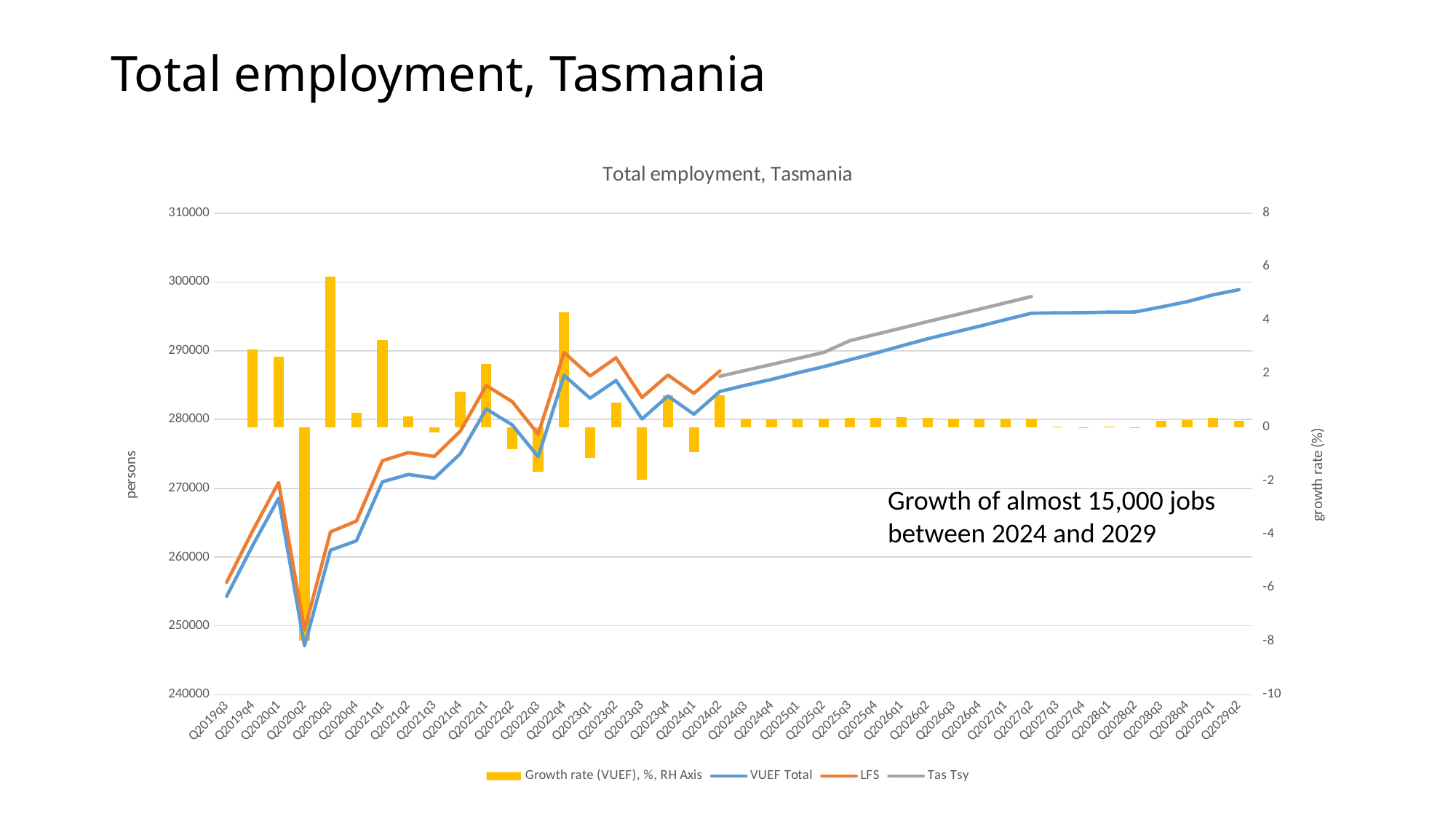
In which quarter does the VUEF Total line reach its lowest value? Q2020q2 How many quarters are shown along the x axis of the chart? 40 What kind of chart is used for the 'Growth rate (VUEF), %, RH Axis' series? bar chart In which quarter is the growth rate (VUEF) bar the lowest? Q2020q2 Does the VUEF Total line rise or fall from Q2024q2 to Q2029q2? rise How many series does the chart legend list? 4 At Q2027q2, which series is higher: Tas Tsy or VUEF Total? Tas Tsy Is the VUEF Total value for Q2020q2 greater or less than 250000? less What is the title of the chart? Total employment, Tasmania In which quarter is the growth rate (VUEF) bar the highest? Q2020q3 Is the VUEF Total value for Q2029q2 greater or less than 290000? greater Is the growth rate (VUEF) value for Q2020q3 greater or less than 4? greater